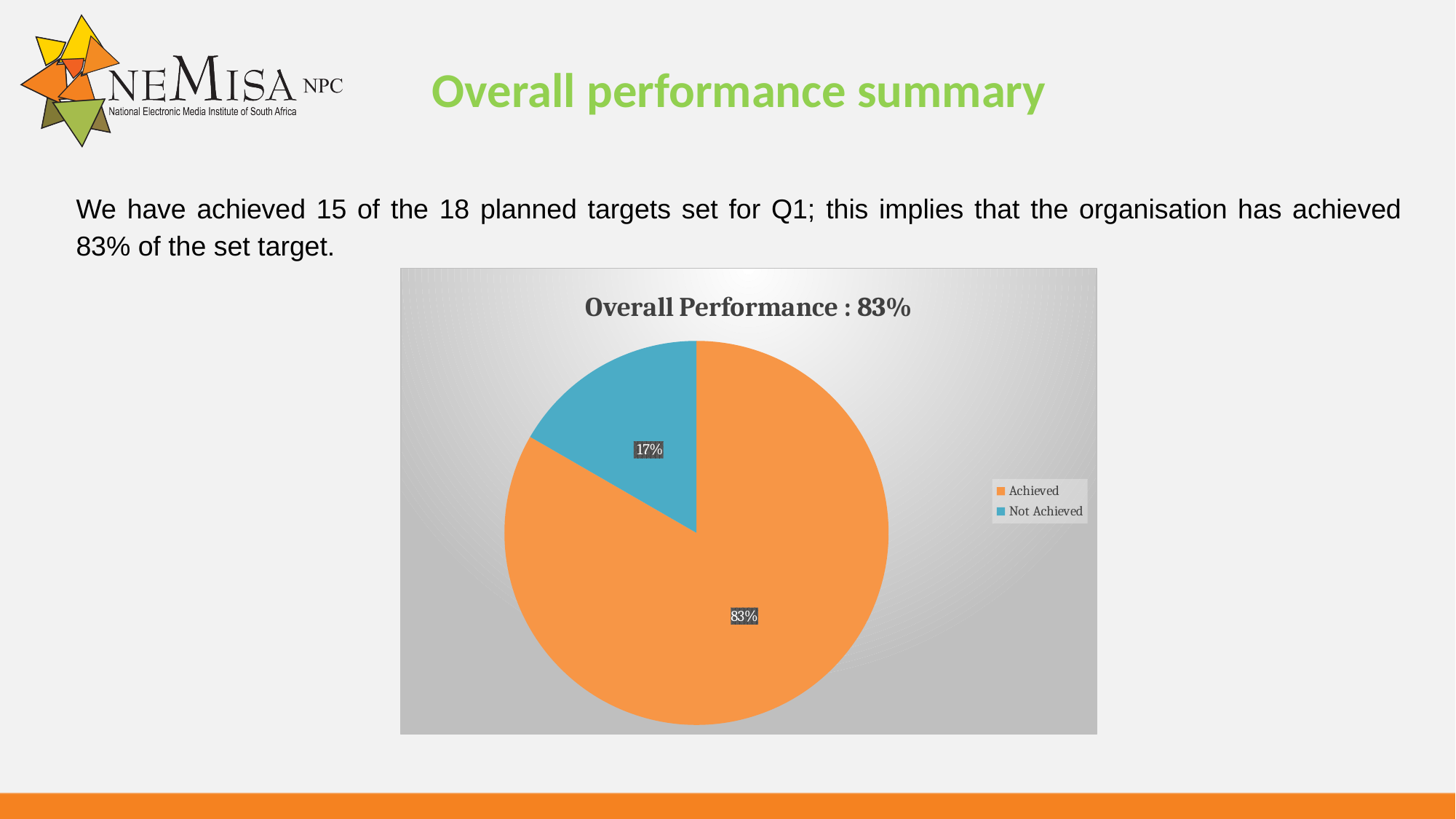
What percentage of the pie is labelled Achieved? 83% Which is larger, the Achieved slice or the Not Achieved slice? Achieved What percentage of the pie is labelled Not Achieved? 17% Which slice of the pie is the smallest? Not Achieved What type of chart is shown on the slide? pie chart How many entries does the legend list? 2 What is the difference in percentage points between the Achieved and Not Achieved slices? 66 What colour is the Achieved slice? orange How many slices does the pie chart have? 2 What is the title of the chart? Overall Performance : 83% What share of the pie does the Not Achieved slice represent? 17% Which slice of the pie is the largest? Achieved